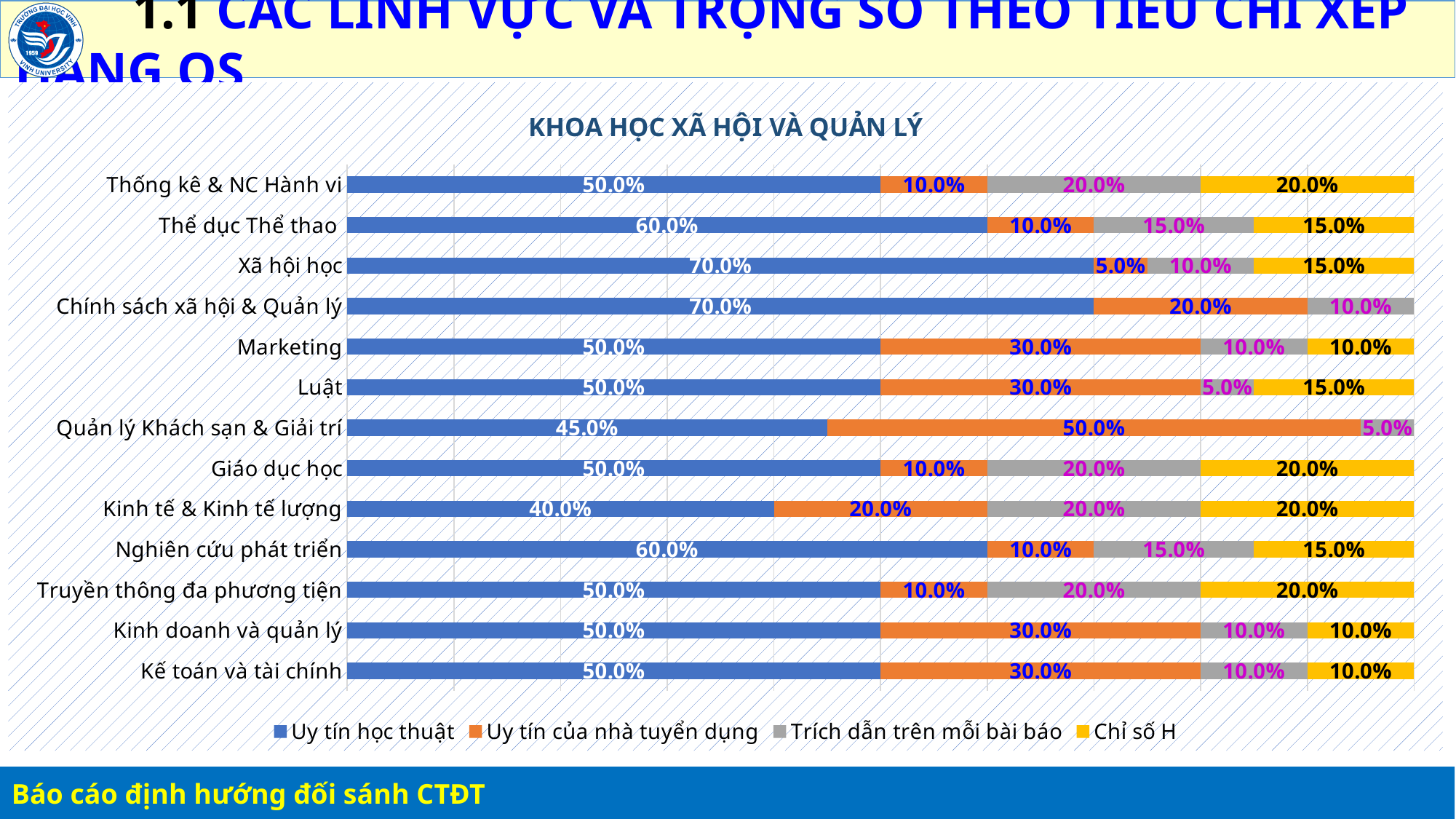
What is the value of Chỉ số H for Xã hội học? 15.0% How many series does the legend list? 4 What is the value of Trích dẫn trên mỗi bài báo for Luật? 5.0% How many categories (fields) are shown on the chart? 13 What is the value of Uy tín của nhà tuyển dụng for Quản lý Khách sạn & Giải trí? 50.0% What is the value of Uy tín học thuật for Kinh tế & Kinh tế lượng? 40.0% What is the title of the chart? KHOA HỌC XÃ HỘI VÀ QUẢN LÝ Which category has the lowest value for Uy tín học thuật? Kinh tế & Kinh tế lượng What is the difference between the Uy tín học thuật values for Xã hội học and Marketing? 20.0% Which is larger: Uy tín của nhà tuyển dụng for Luật or for Thể dục Thể thao? Luật What type of chart is shown on the slide? Stacked bar chart Which category has the highest value for Uy tín của nhà tuyển dụng? Quản lý Khách sạn & Giải trí